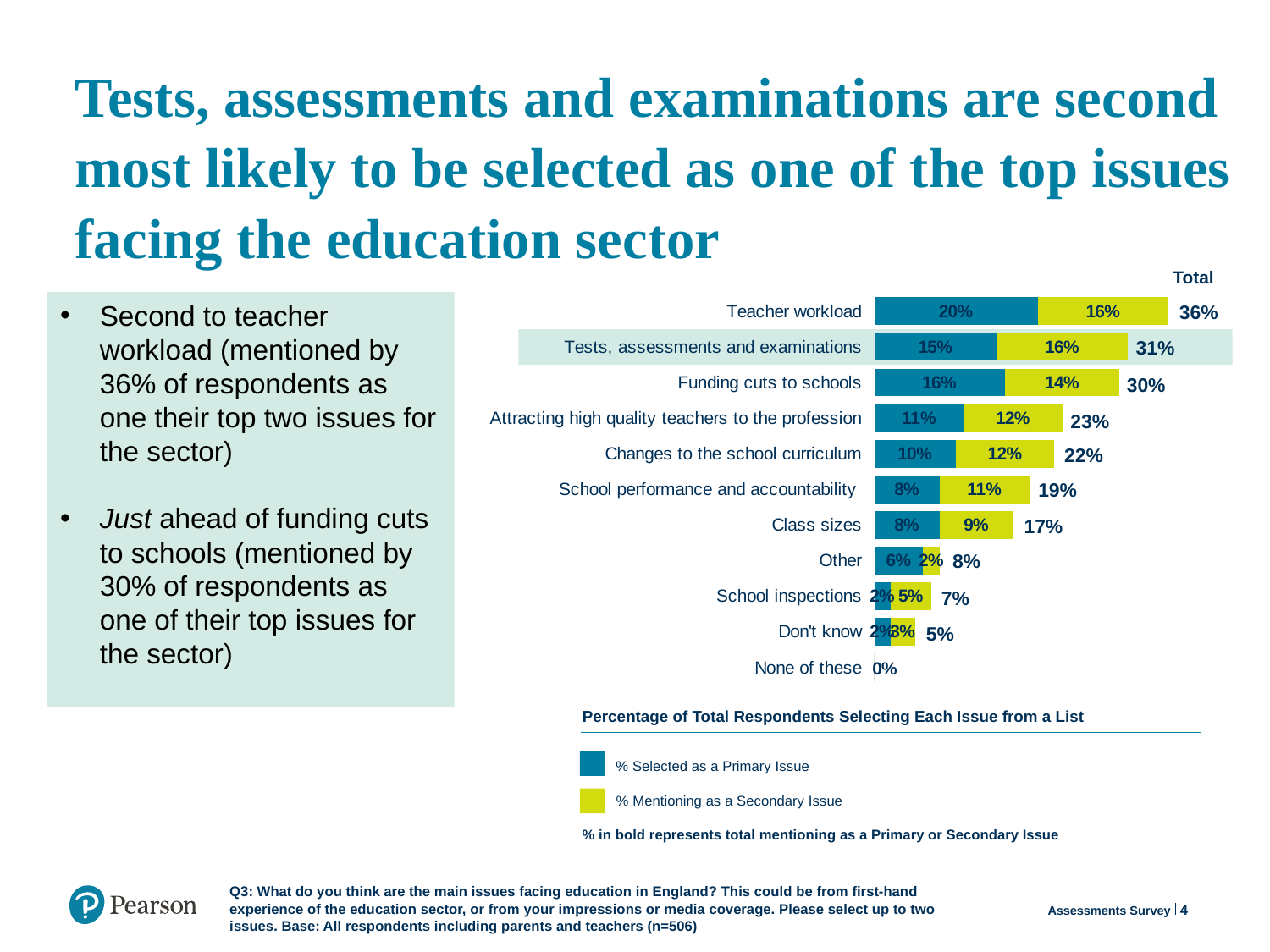
What kind of chart is shown on the slide? Stacked bar chart Which issue has the lowest total percentage of respondents mentioning it? None of these Which issue has the highest total percentage of respondents mentioning it? Teacher workload What is the total of the stacked bar for Changes to the school curriculum? 22% How many issue categories are shown in the chart? 11 Which has a higher primary-issue percentage: Funding cuts to schools or Tests, assessments and examinations? Funding cuts to schools What is the difference between the total for Teacher workload and the total for Tests, assessments and examinations? 5% What does the yellow-green colour in the chart represent? % Mentioning as a Secondary Issue What percentage selected Teacher workload as a primary issue? 20% What percentage mentioned Class sizes as a secondary issue? 9% How many series does the legend list? 2 What is the total percentage mentioning Funding cuts to schools as a primary or secondary issue? 30%